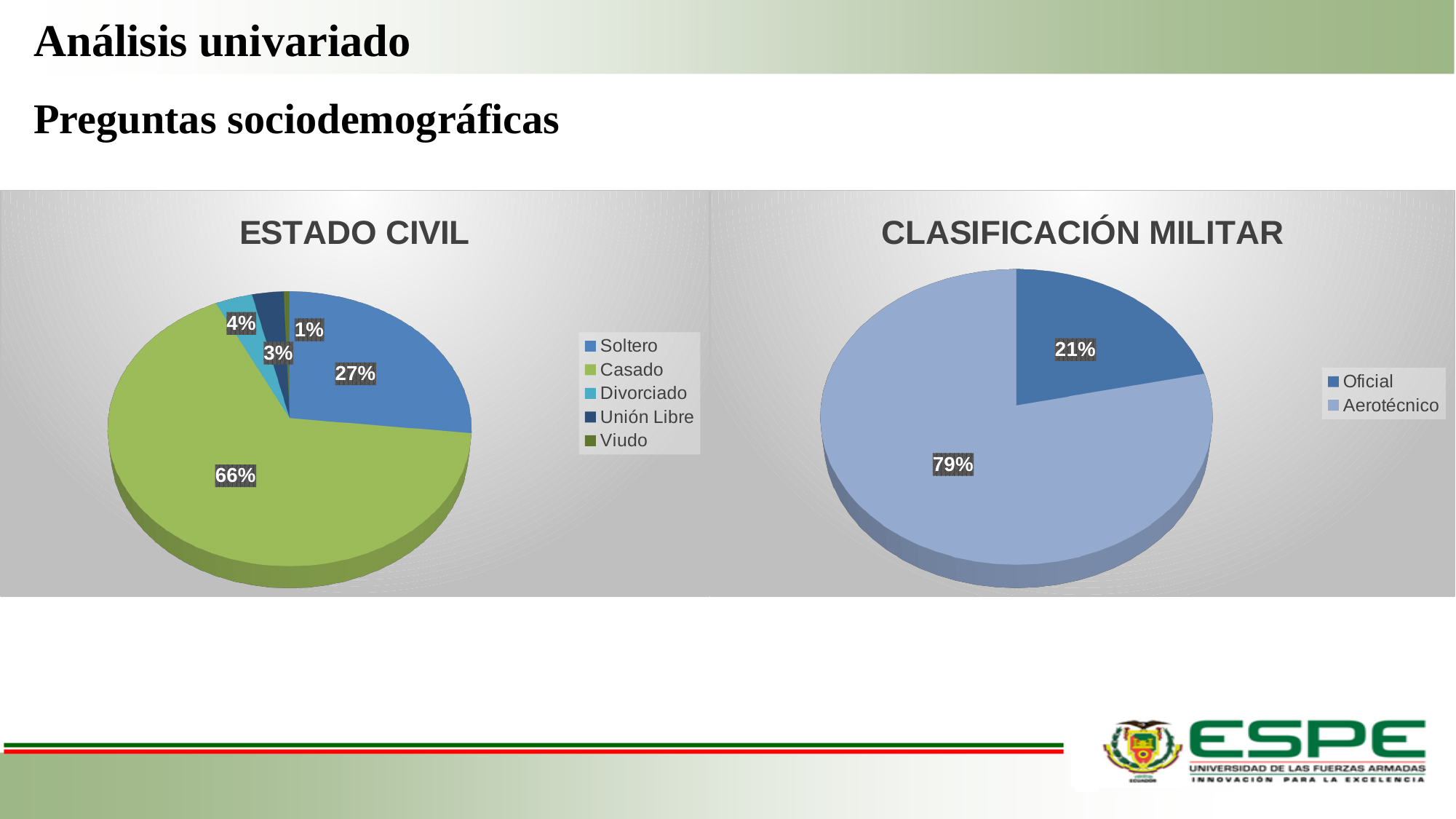
In the ESTADO CIVIL chart, which is larger, Divorciado or Unión Libre? Divorciado What kind of chart is the CLASIFICACIÓN MILITAR chart? Pie chart In the ESTADO CIVIL chart, what is the difference between the Casado and Soltero shares? 39% What is the title of the chart on the left side of the slide? ESTADO CIVIL In the CLASIFICACIÓN MILITAR chart, what is the difference between the Aerotécnico and Oficial shares? 58% In the ESTADO CIVIL chart, how many categories does the legend list? 5 In the ESTADO CIVIL chart, which category has the largest share? Casado In the ESTADO CIVIL chart, what share is Casado? 66% In the CLASIFICACIÓN MILITAR chart, what share is Oficial? 21% In the CLASIFICACIÓN MILITAR chart, what share is Aerotécnico? 79% In the ESTADO CIVIL chart, which category has the smallest share? Viudo In the ESTADO CIVIL chart, what share is Soltero? 27%